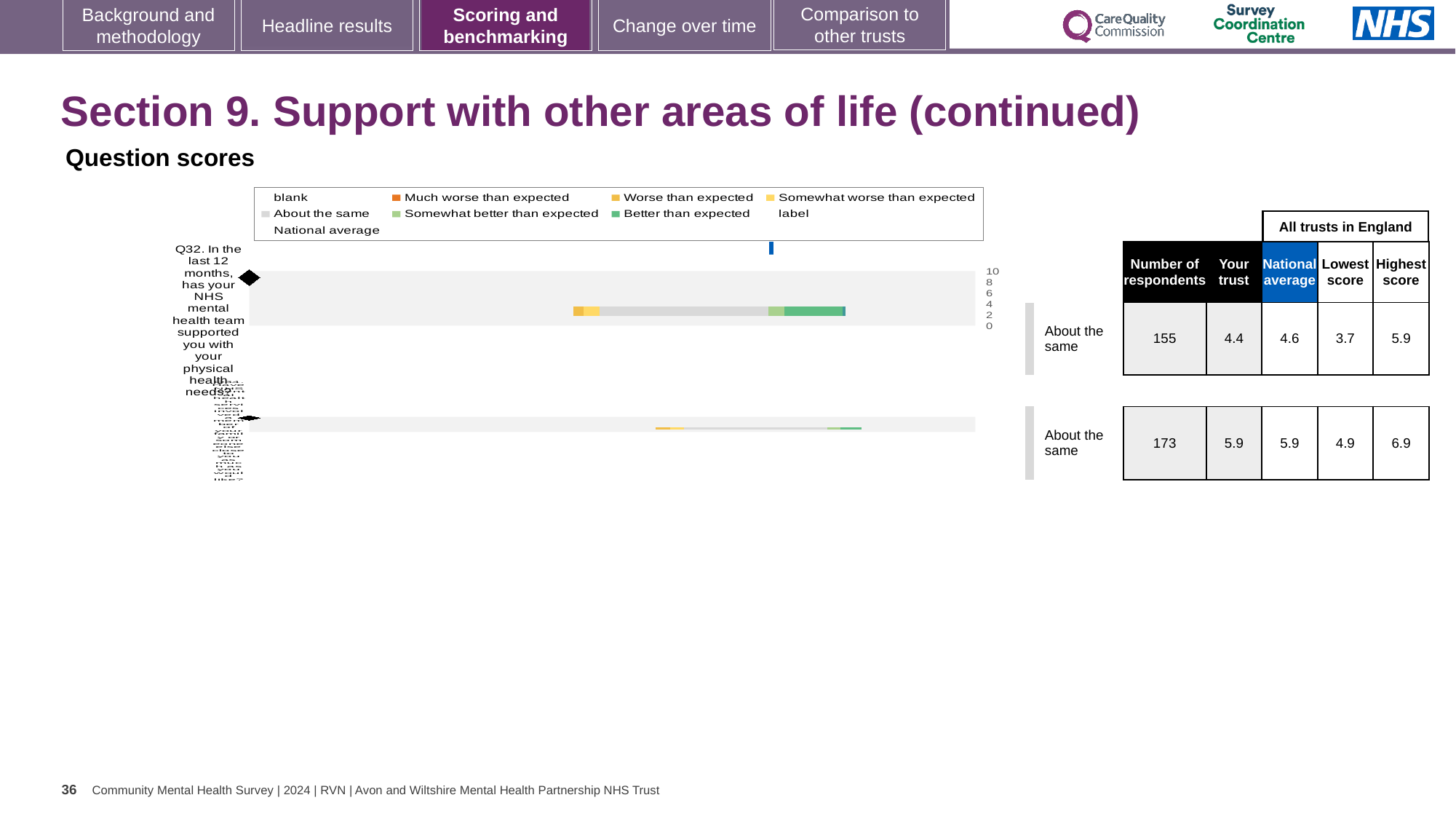
How many respondents answered the second question row in the chart? 173 What is the lowest score among all trusts in England for Q32? 3.7 For Q32, which is larger: the 'Your trust' score or the national average? National average What is the national average score for Q32? 4.6 For Q32, what is the difference between the highest and lowest scores among all trusts in England? 2.2 What is the 'Your trust' score for Q32 (support with physical health needs)? 4.4 What benchmarking category label is shown for Q32? About the same What is the highest score among all trusts in England for Q32? 5.9 How many respondents answered Q32? 155 What is the 'Your trust' score for the second question row in the chart? 5.9 How many questions (rows) are plotted in the question scores chart? 2 What kind of chart is used to show the question scores on this slide? bar chart